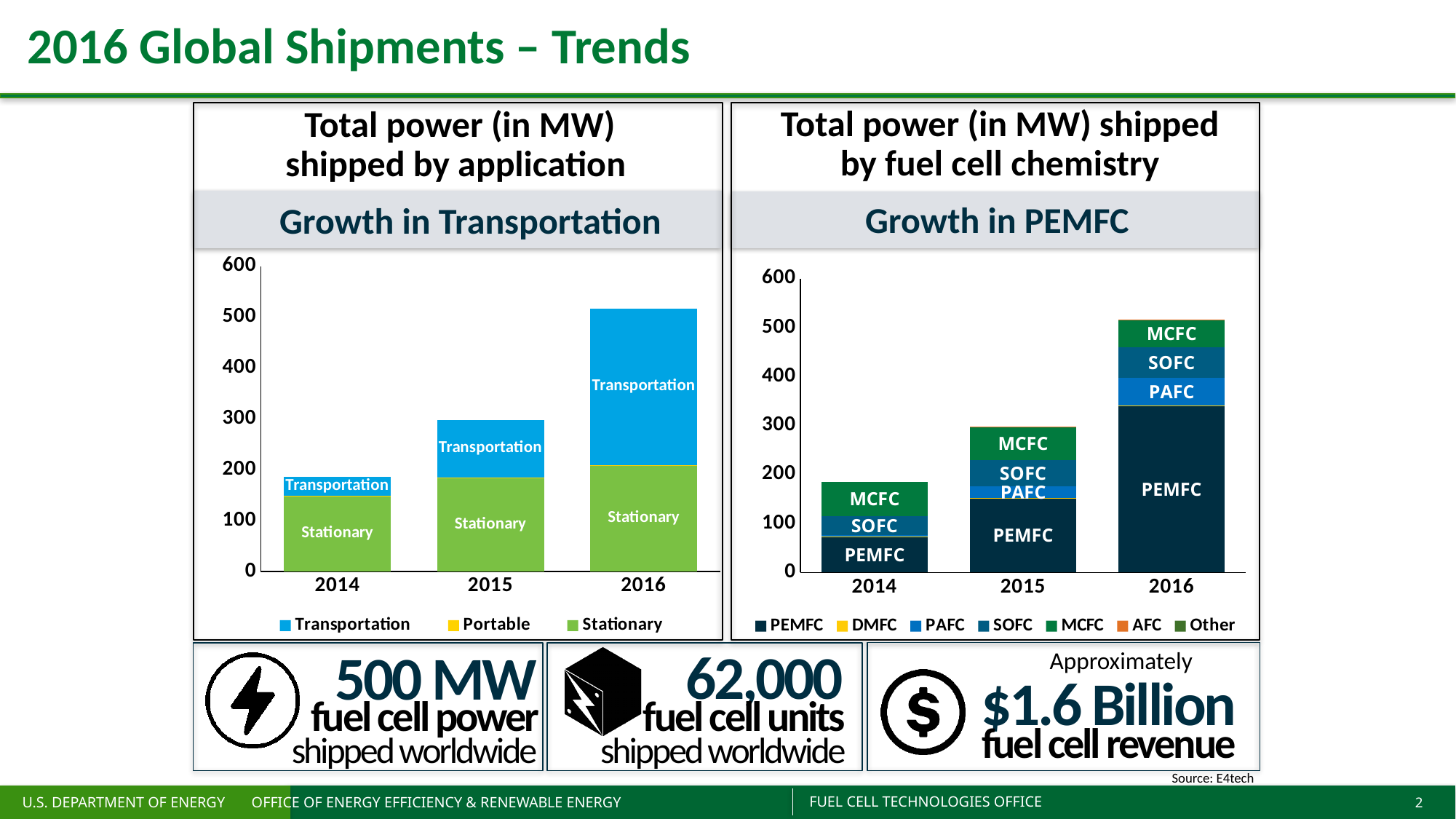
In the 'Total power (in MW) shipped by application' chart, is the total for 2016 greater or less than 400? greater In the 'Total power (in MW) shipped by application' chart, how many years are shown on the x axis? 3 In the 'Total power (in MW) shipped by fuel cell chemistry' chart, do the total bars rise or fall from 2014 to 2016? rise In the 'Total power (in MW) shipped by fuel cell chemistry' chart, is the total for 2014 greater or less than 200? less In the 'Total power (in MW) shipped by application' chart, which year has the tallest total bar? 2016 In the 'Total power (in MW) shipped by fuel cell chemistry' chart, which year has the shortest total bar? 2014 In the 'Total power (in MW) shipped by application' chart, which is larger in 2016, the Transportation segment or the Stationary segment? Transportation In the 'Total power (in MW) shipped by fuel cell chemistry' chart, how many series does the legend list? 7 In the 'Total power (in MW) shipped by application' chart, how many series does the legend list? 3 In the 'Total power (in MW) shipped by fuel cell chemistry' chart, which series is shown in the darkest navy colour at the bottom of each bar? PEMFC In the 'Total power (in MW) shipped by application' chart, is the total for 2014 greater or less than 200? less What type of chart is the 'Total power (in MW) shipped by application' chart? stacked bar chart